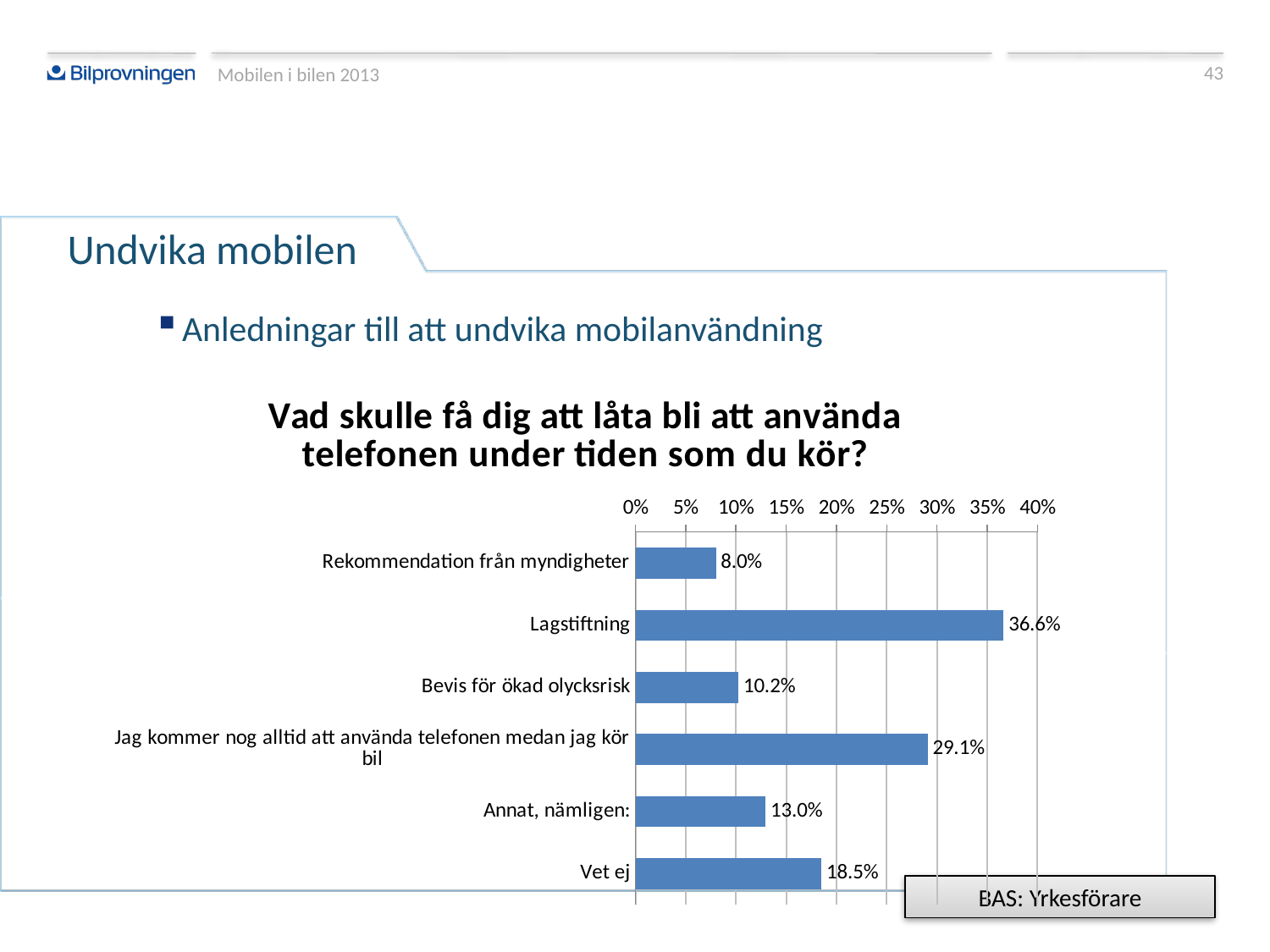
Which category has the lowest value? Rekommendation från myndigheter Which category has the highest value? Lagstiftning What is the value for Vet ej? 18.5% How many categories are shown in the chart? 6 Is the value for Jag kommer nog alltid att använda telefonen medan jag kör bil greater or less than 25%? greater What is the title of the chart? Vad skulle få dig att låta bli att använda telefonen under tiden som du kör? What is the value for Rekommendation från myndigheter? 8.0% What is the value for Bevis för ökad olycksrisk? 10.2% What kind of chart is shown on the slide? bar chart What is the difference between the values for Lagstiftning and Jag kommer nog alltid att använda telefonen medan jag kör bil? 7.5% Which is larger, the value for Annat, nämligen: or the value for Vet ej? Vet ej What is the value for Lagstiftning? 36.6%